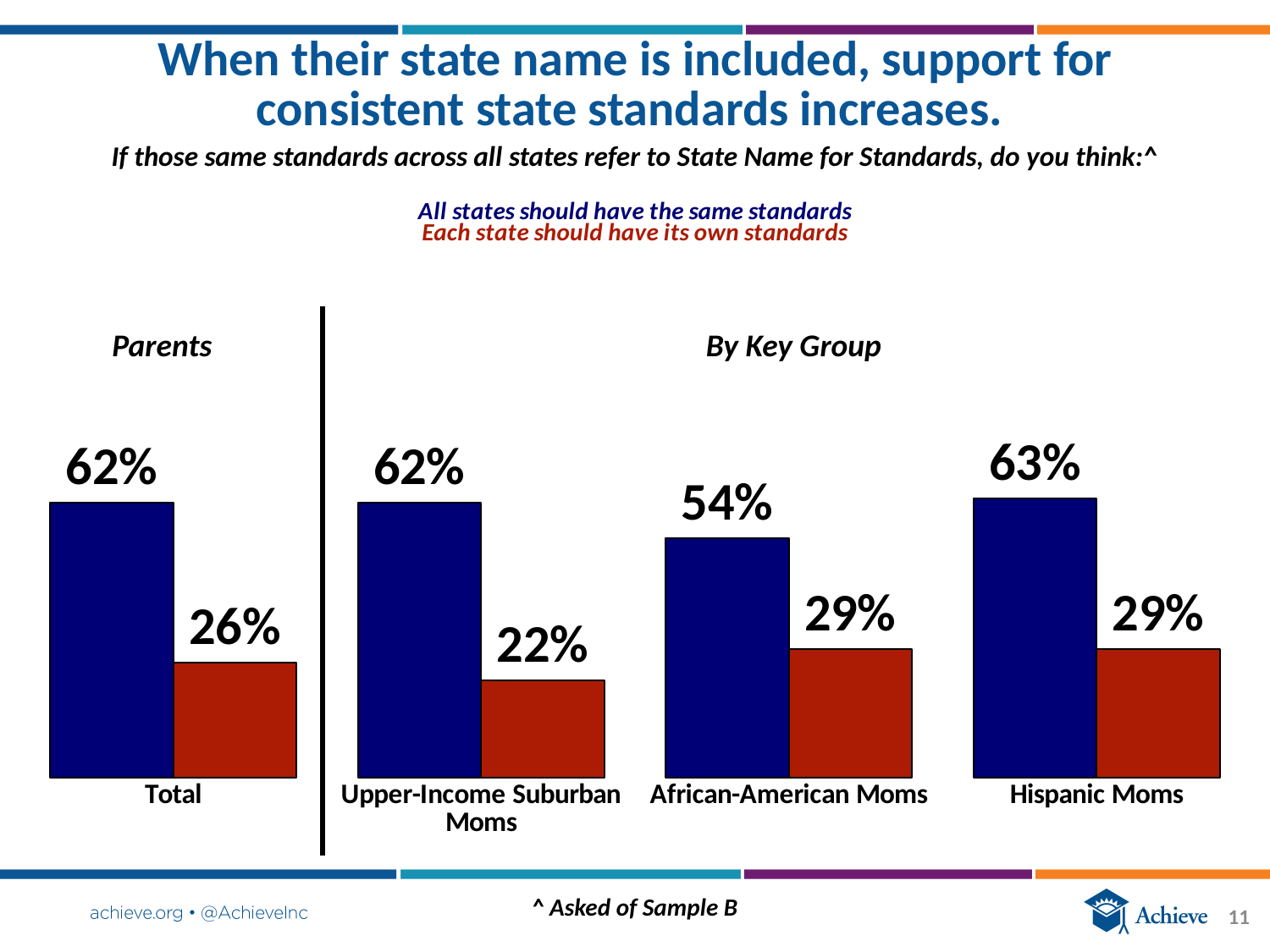
In the By Key Group chart, which group has the lowest share saying all states should have the same standards? African-American Moms In the By Key Group chart, which group has the highest share saying all states should have the same standards? Hispanic Moms How many groups are shown in the By Key Group chart? 3 In the By Key Group chart, what is the difference between the share of Hispanic Moms saying all states should have the same standards and the share saying each state should have its own standards? 34% In the Parents chart, what is the difference between the two values shown for Total? 36% In the By Key Group chart, what percentage of Upper-Income Suburban Moms say each state should have its own standards? 22% In the By Key Group chart, which is larger: the share of Upper-Income Suburban Moms or the share of African-American Moms saying each state should have its own standards? African-American Moms In the By Key Group chart, what percentage of African-American Moms say all states should have the same standards? 54% In the Parents chart, what percentage of the Total group say all states should have the same standards? 62% In the Parents chart, what percentage of the Total group say each state should have its own standards? 26% What type of chart is used on this slide? Bar chart How many series does the legend list for the charts? 2